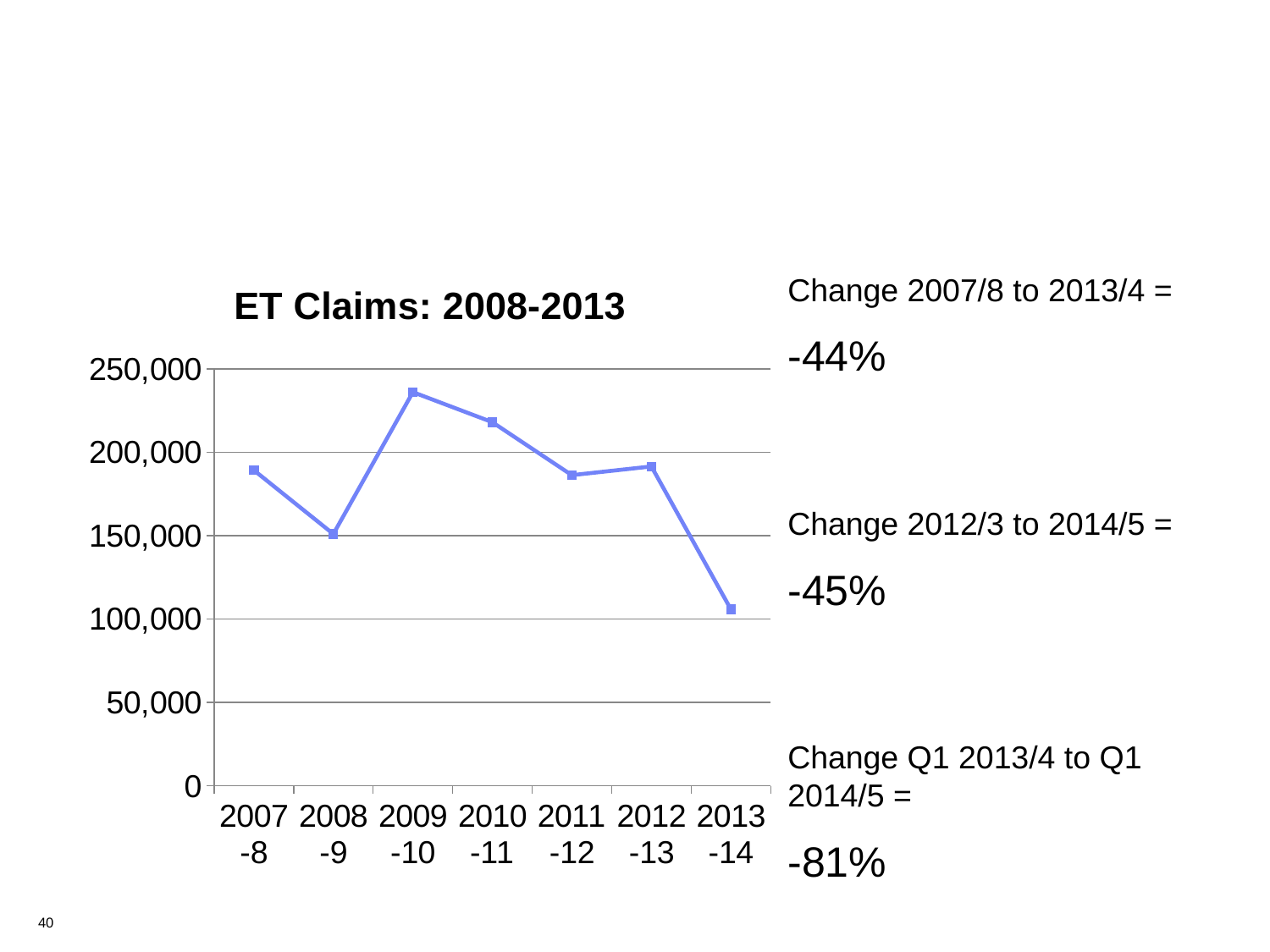
Is the value for 2008-9 greater or less than 200,000? less Is the value for 2007-8 greater or less than 150,000? greater What kind of chart is shown on the slide? line chart How many years are plotted on the x axis of the chart? 7 Which is larger, the value for 2010-11 or the value for 2013-14? 2010-11 Do the values rise or fall from 2009-10 to 2013-14 overall? fall Which year has the highest number of ET claims? 2009-10 Which is larger, the value for 2009-10 or the value for 2008-9? 2009-10 Which year has the lowest number of ET claims? 2013-14 Is the value for 2013-14 greater or less than 150,000? less What is the title of the chart? ET Claims: 2008-2013